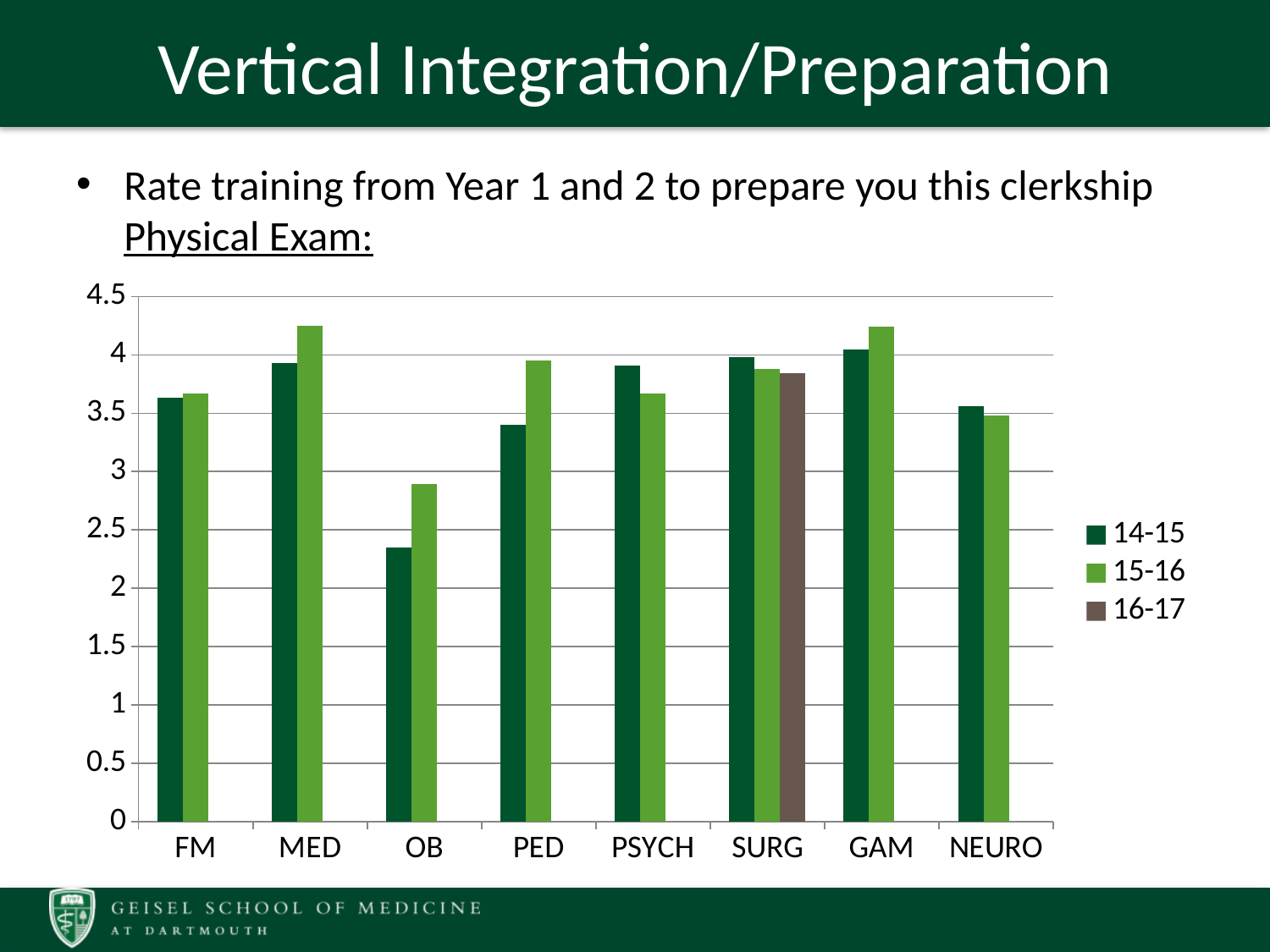
What kind of chart is shown on the slide? bar chart Which category is the only one with a 16-17 bar? SURG How many series does the legend list? 3 How many clerkship categories are shown on the x axis? 8 Which category has the lowest value for the 14-15 series? OB Is the 14-15 value for PED greater or less than 3.5? less Which category has the lowest value for the 15-16 series? OB Is the 15-16 value for OB greater or less than 3? less Is the 14-15 value for OB greater or less than 2.5? less For PED, which series has the larger value, 14-15 or 15-16? 15-16 For PSYCH, which series has the larger value, 14-15 or 15-16? 14-15